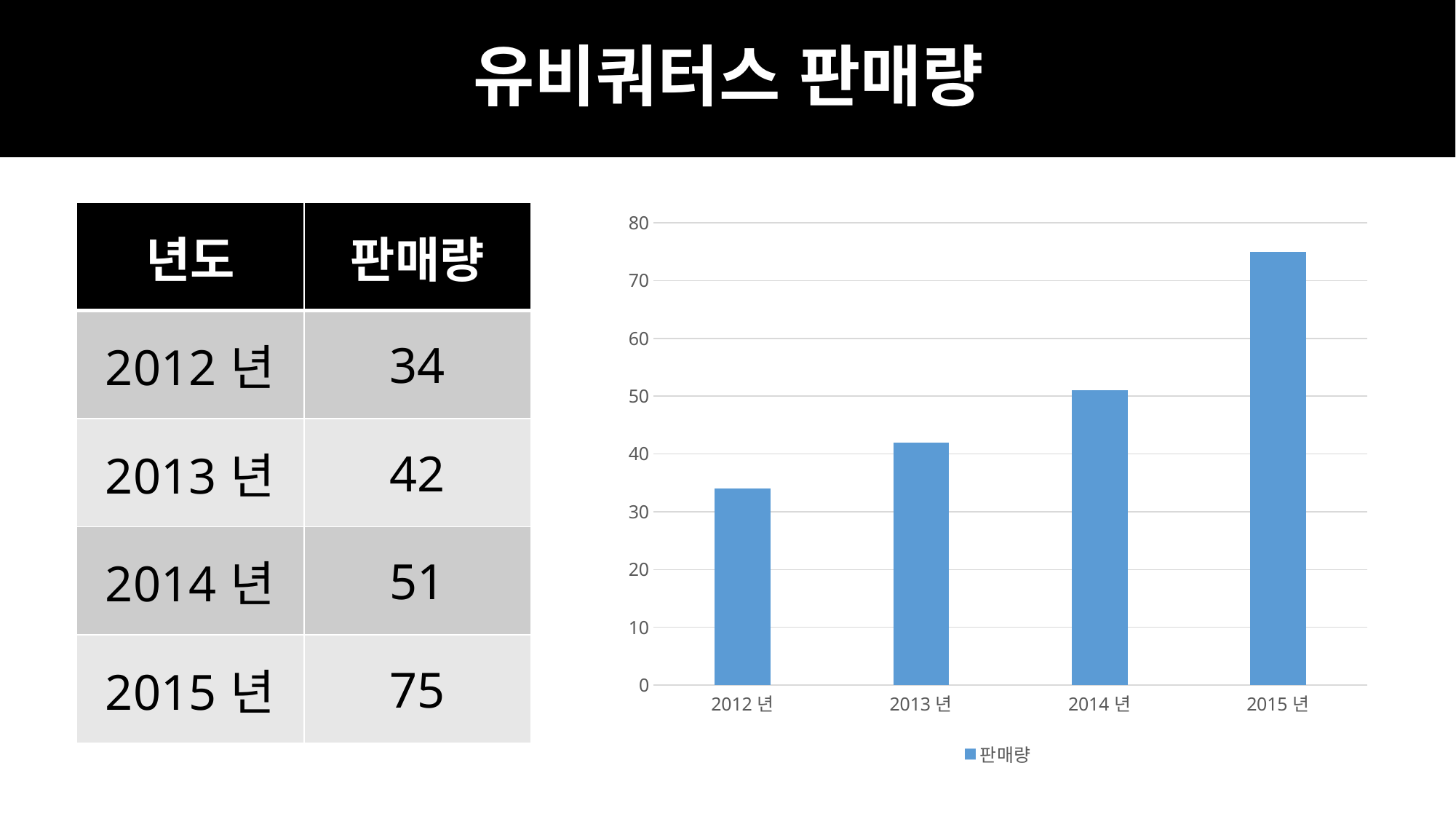
How many years are plotted on the x axis of the chart? 4 Do the 판매량 values rise or fall from 2012 년 to 2015 년? rise Is the value for 2014 년 greater or less than 50? greater What is the difference in 판매량 between 2015 년 and 2014 년? 24 What kind of chart is shown on the slide? bar chart Which year has the highest 판매량? 2015 년 What is the title of the slide containing the chart? 유비쿼터스 판매량 Which year has the lowest 판매량? 2012 년 Which is larger, the 판매량 for 2013 년 or for 2014 년? 2014 년 What is the 판매량 value for 2012 년? 34 How many series does the chart legend list? 1 What is the 판매량 value for 2015 년? 75